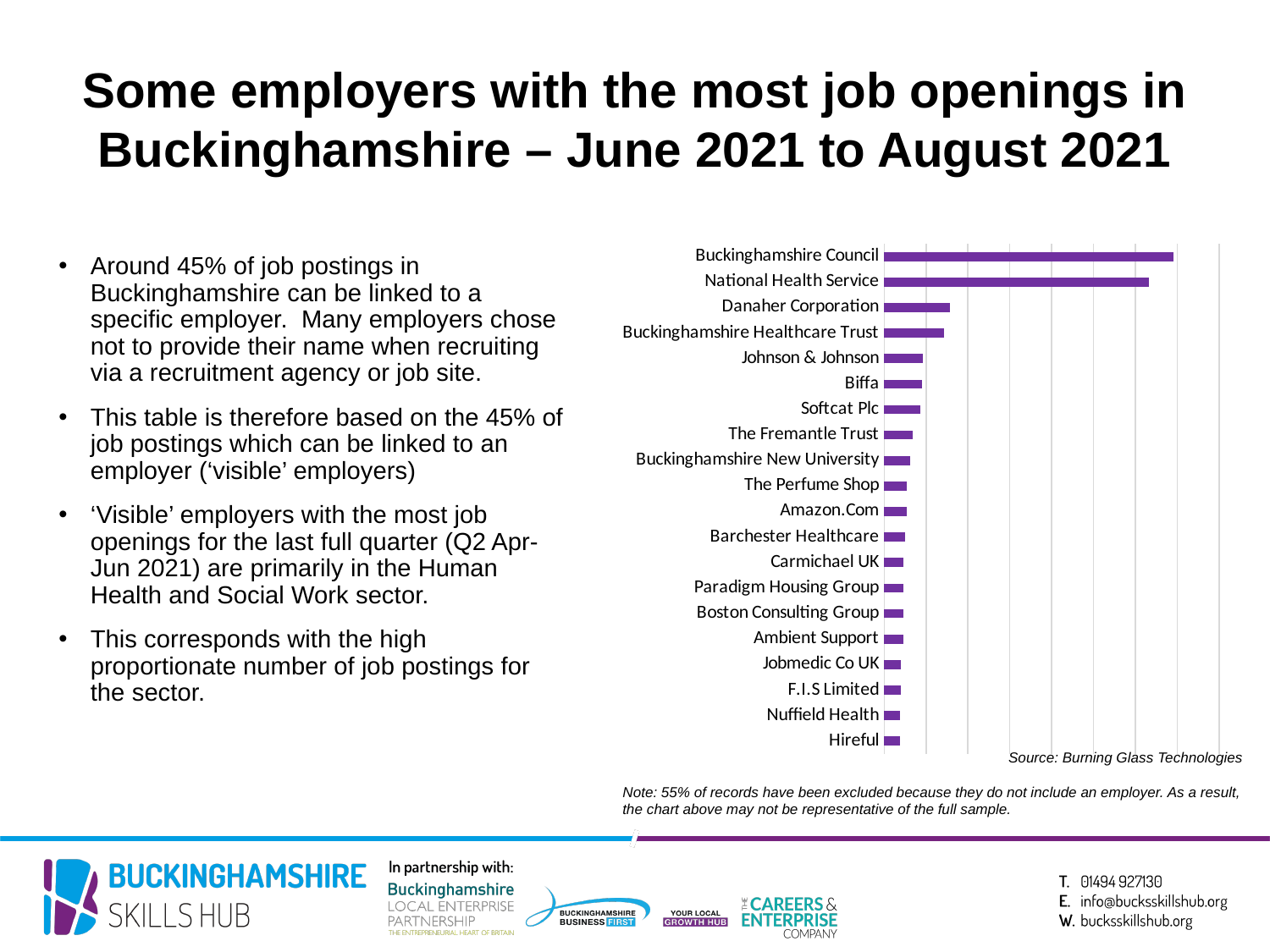
What source is cited for the chart? Burning Glass Technologies Which has the longer bar, Biffa or Nuffield Health? Biffa Which employer has the second-longest bar in the chart? National Health Service Which has the longer bar, National Health Service or Buckinghamshire Healthcare Trust? National Health Service Which employer has the longest bar in the chart? Buckinghamshire Council Which has the longer bar, Danaher Corporation or Johnson & Johnson? Danaher Corporation What colour are the bars in the chart? Purple Are the bars in the chart ordered from longest at the top to shortest at the bottom? Yes How many employers are listed in the chart? 20 Which employer has the shortest bar in the chart? Nuffield Health and Hireful (tied) What kind of chart is shown on the slide? Bar chart